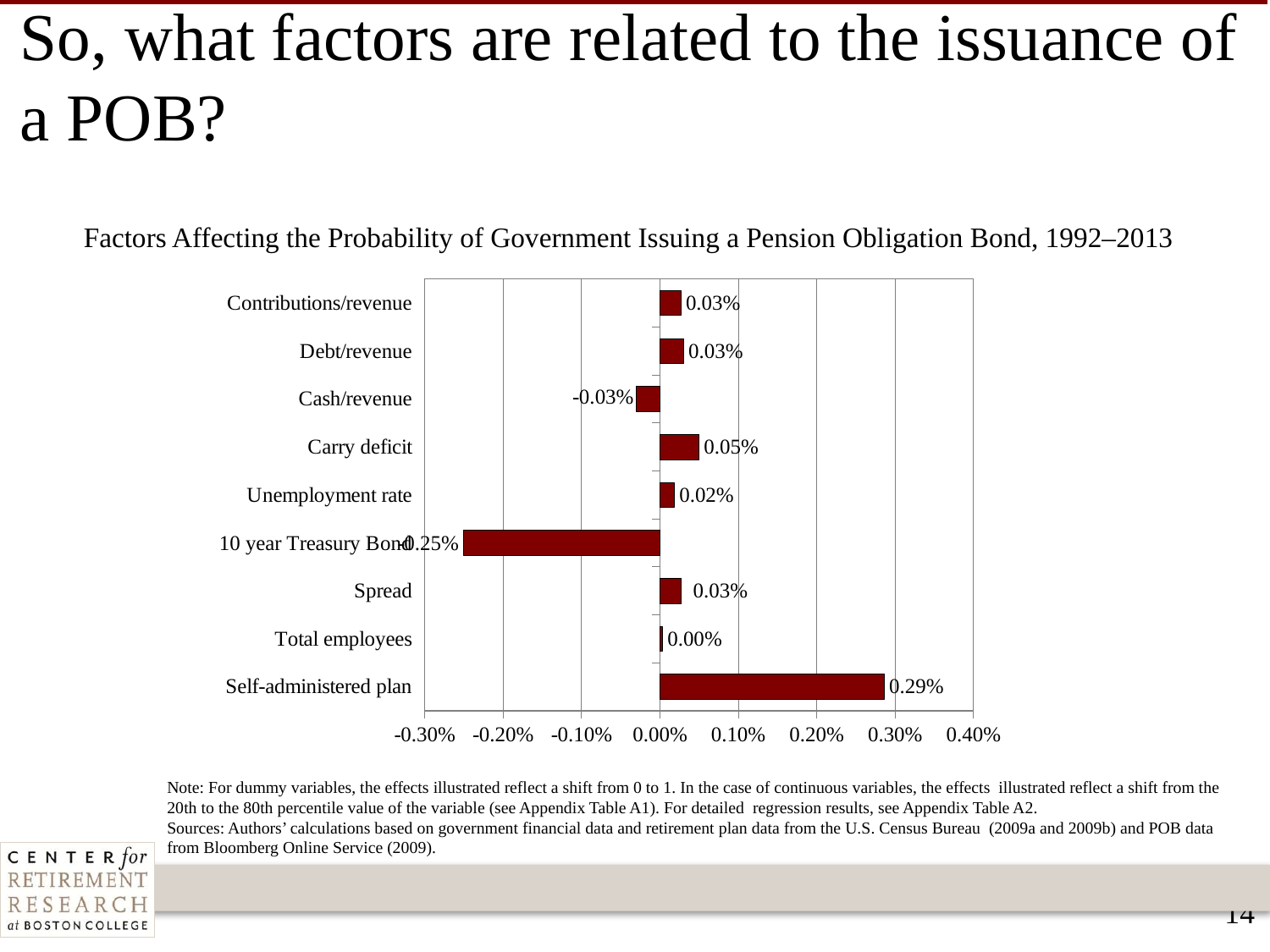
What is the difference between the values for Self-administered plan and Carry deficit? 0.24% Which is larger, the value for Carry deficit or the value for Unemployment rate? Carry deficit How many categories are shown in the chart? 9 What is the value for Carry deficit? 0.05% Which category has the lowest value? 10 year Treasury Bond What is the value for Unemployment rate? 0.02% Is the value for 10 year Treasury Bond greater or less than -0.20%? less Which category has the highest value? Self-administered plan What is the value for Total employees? 0.00% What is the value for Cash/revenue? -0.03% What kind of chart is shown on the slide? Bar chart What is the value for Self-administered plan? 0.29%